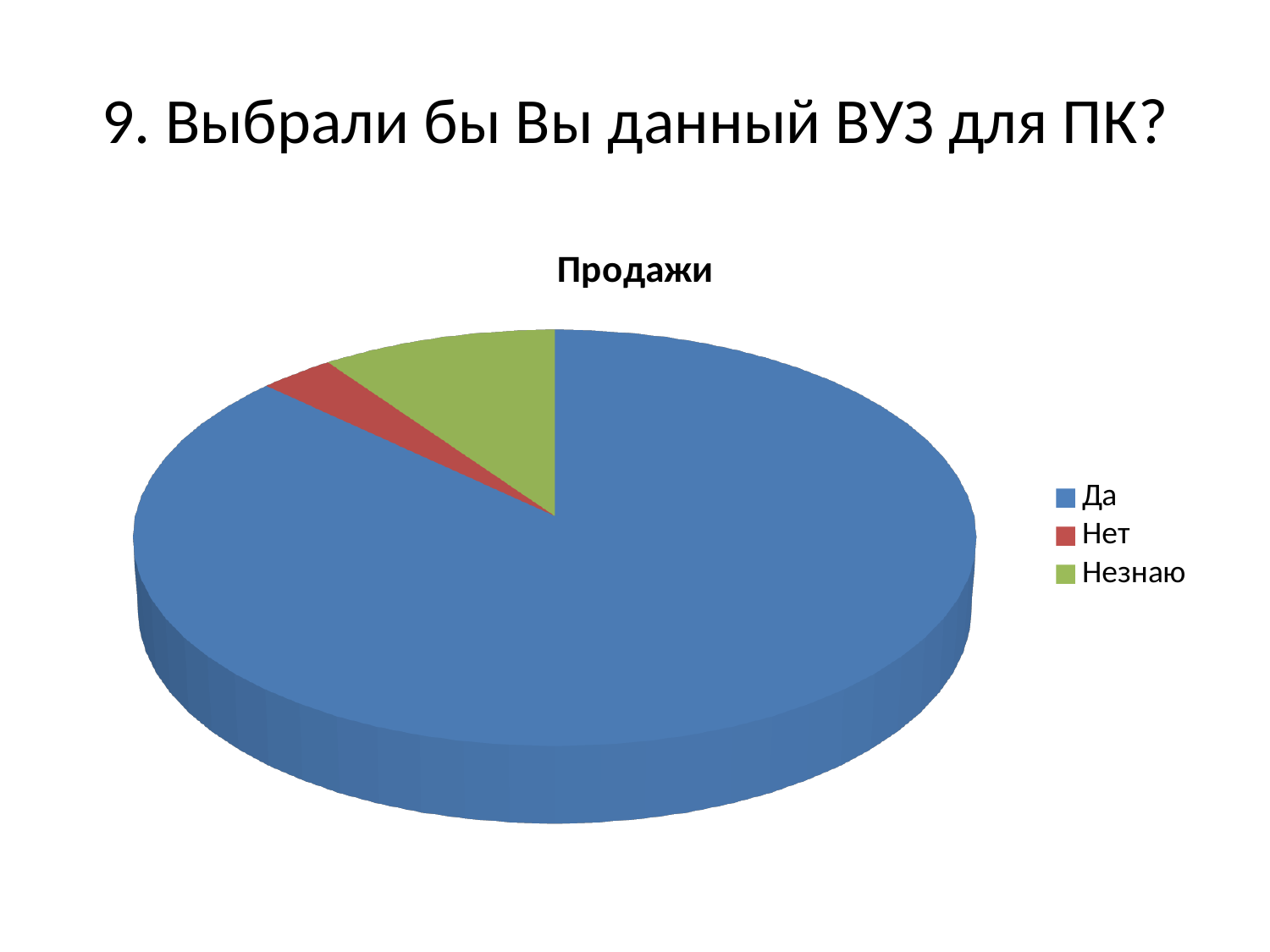
What colour is the slice for Незнаю in the pie chart? green Which category has the largest slice in the pie chart? Да Which slice is larger, Да or Незнаю? Да Which category has the smallest slice in the pie chart? Нет What kind of chart is shown on the slide? pie chart What is the title of the pie chart? Продажи Which slice is larger, Незнаю or Нет? Незнаю How many entries does the legend of the pie chart list? 3 How many slices does the pie chart have? 3